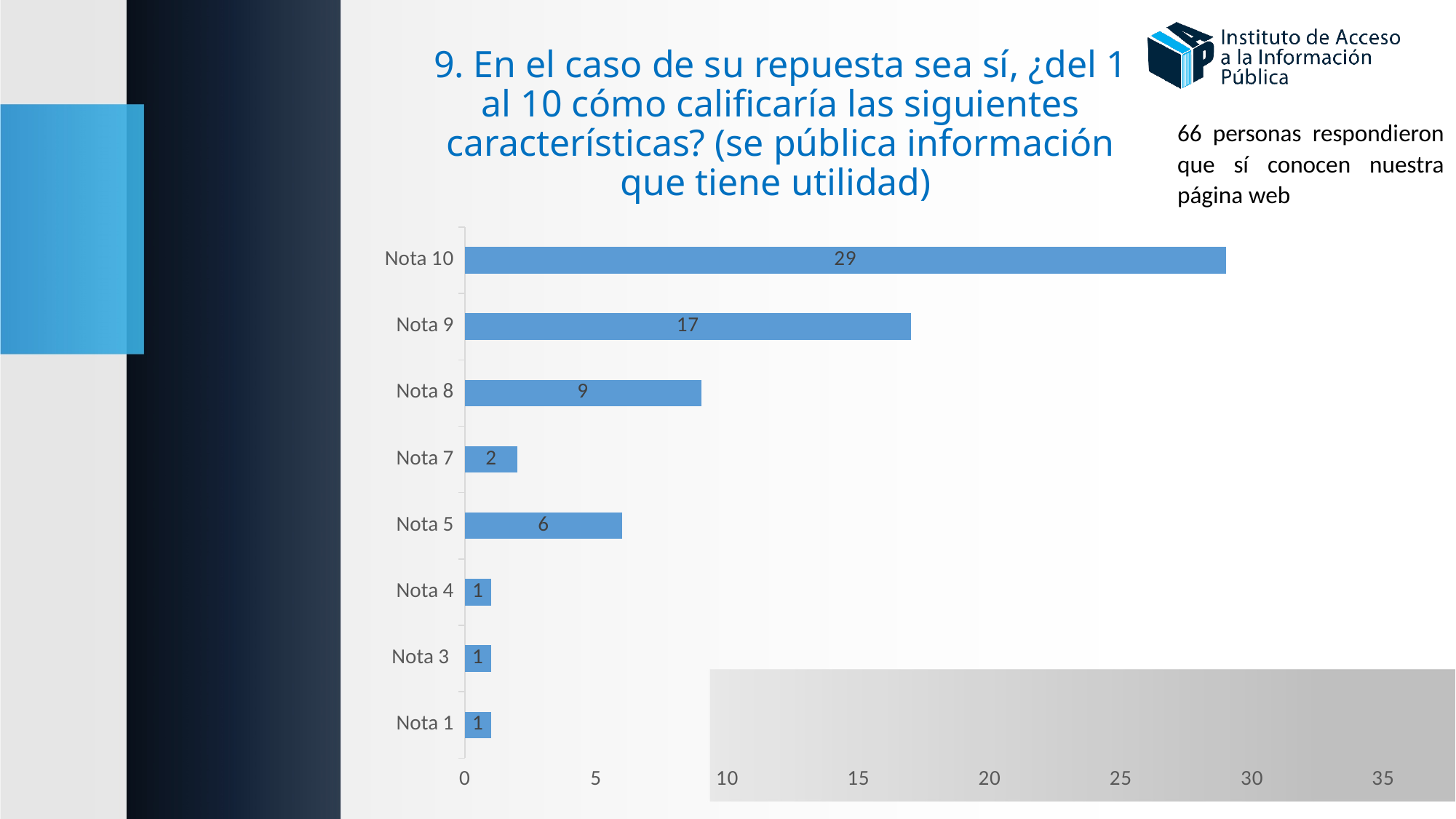
How many categories are shown on the chart? 8 What is the difference between the values for Nota 8 and Nota 7? 7 What is the highest value shown on the horizontal axis? 35 What is the value for Nota 8? 9 What is the value for Nota 5? 6 Is the value for Nota 10 greater or less than 25? greater What kind of chart is shown on the slide? Bar chart What is the value for Nota 10? 29 What is the difference between the values for Nota 10 and Nota 9? 12 Which is larger, the value for Nota 7 or the value for Nota 5? Nota 5 Which category has the highest value? Nota 10 What is the value for Nota 9? 17